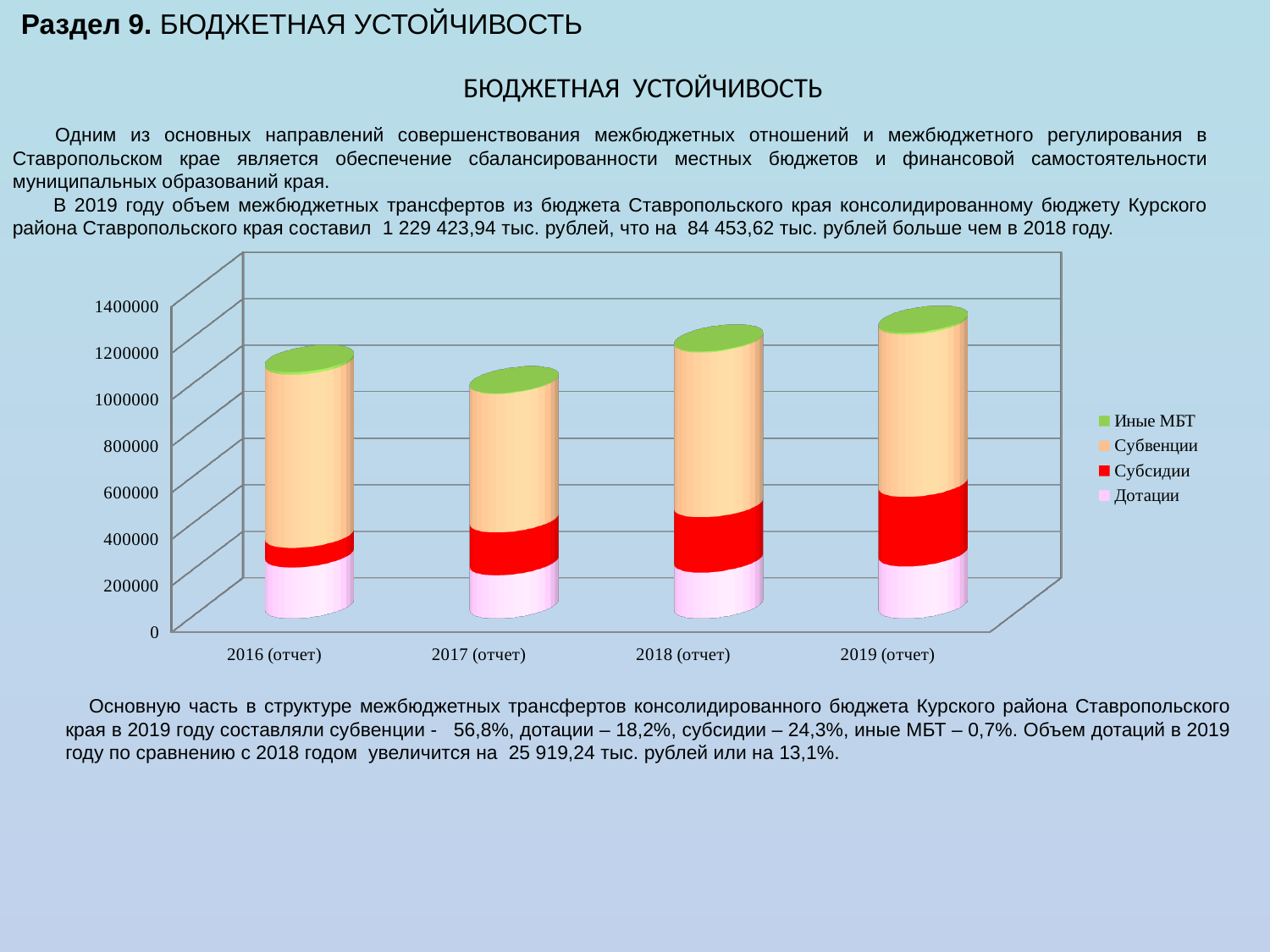
What kind of chart is shown on the slide? bar chart Which year has the shortest stacked bar in the chart? 2017 (отчет) From 2017 (отчет) to 2019 (отчет), do the total stacked bar heights rise or fall? rise Which stacked bar is taller: 2018 (отчет) or 2016 (отчет)? 2018 (отчет) How many categories (years) are shown on the x axis of the chart? 4 Which series forms the bottom segment of each stacked bar? Дотации Which series is shown in red in the chart legend? Субсидии Is the total value of the 2017 (отчет) bar greater or less than 1200000? less Which year has the tallest stacked bar in the chart? 2019 (отчет) Is the total value of the 2016 (отчет) bar greater or less than 1000000? greater How many series does the chart legend list? 4 Is the total stacked bar for 2019 (отчет) larger or smaller than the one for 2017 (отчет)? larger